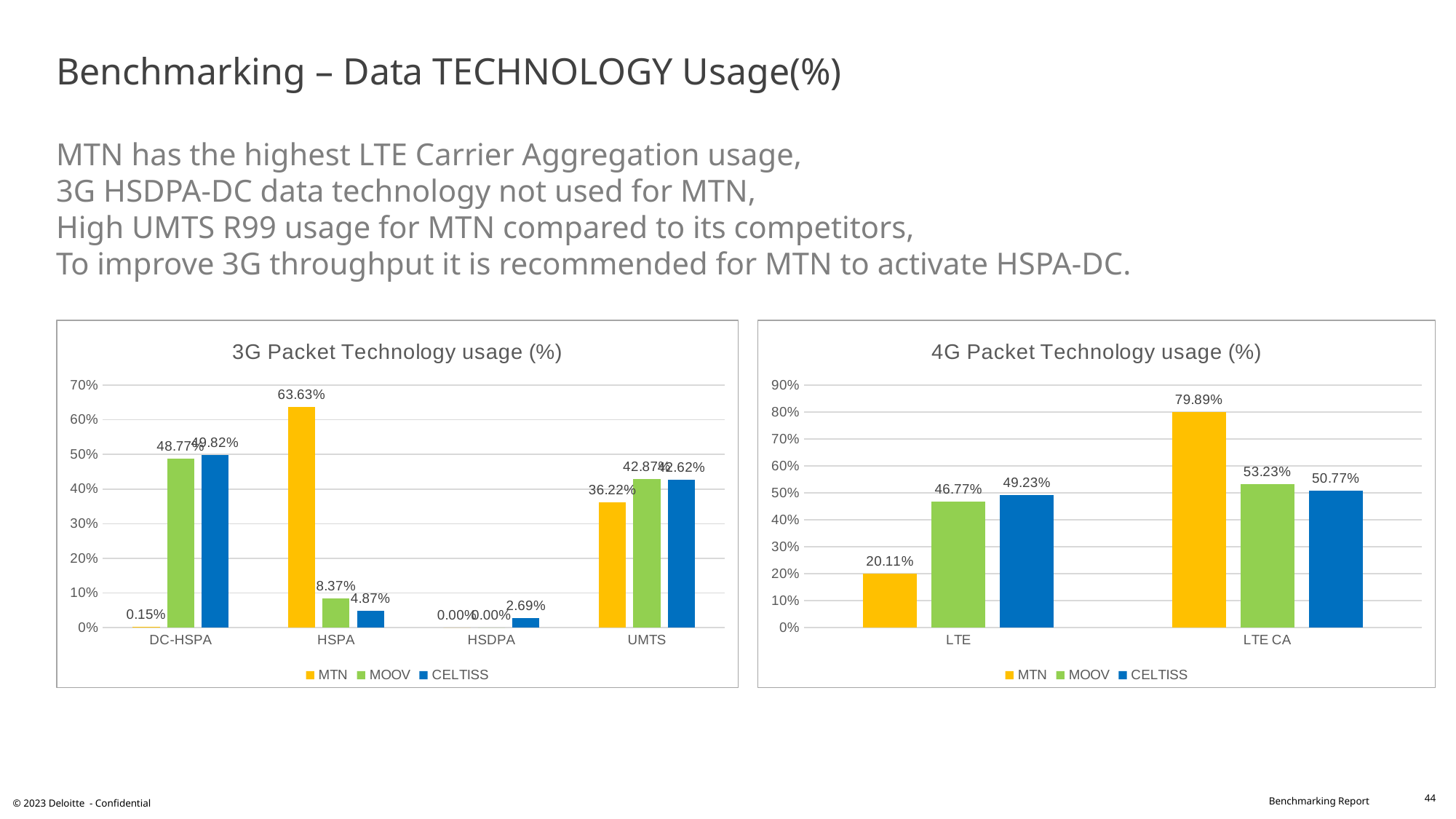
In the 4G Packet Technology usage (%) chart, what is the MTN value for LTE CA? 79.89% In the 3G Packet Technology usage (%) chart, what is the MTN value for UMTS? 36.22% In the 3G Packet Technology usage (%) chart, what is the difference between the MOOV and CELTISS values for HSPA? 3.50% In the 4G Packet Technology usage (%) chart, what is the MOOV value for LTE? 46.77% In the 3G Packet Technology usage (%) chart, which category has the highest MTN value? HSPA In the 3G Packet Technology usage (%) chart, what is the MTN value for HSPA? 63.63% How many series does the legend of the 4G Packet Technology usage (%) chart list? 3 In the 3G Packet Technology usage (%) chart, what is the CELTISS value for DC-HSPA? 49.82% In the 4G Packet Technology usage (%) chart, what is the difference between the MTN values for LTE CA and LTE? 59.78% In the 3G Packet Technology usage (%) chart, how many categories are shown on the x axis? 4 In the 4G Packet Technology usage (%) chart, is the CELTISS value for LTE CA greater or less than 60%? less In the 4G Packet Technology usage (%) chart, which series has the lowest value for LTE? MTN